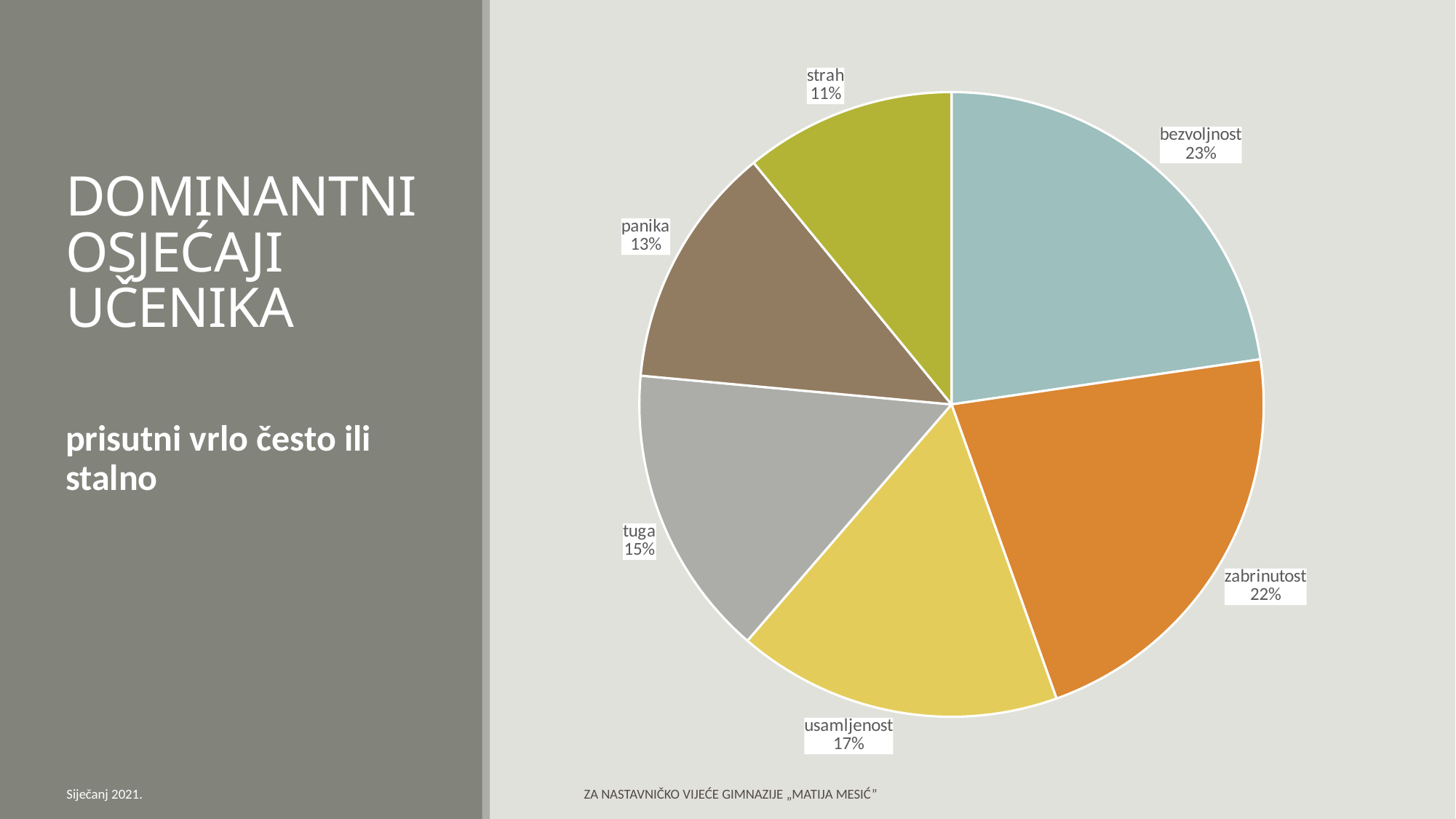
What is the difference in percentage points between usamljenost and panika? 4 How many slices does the pie chart have? 6 Which is larger, tuga or strah? tuga What share of the pie does strah have? 11% What share of the pie does bezvoljnost have? 23% What share of the pie does zabrinutost have? 22% Which slice of the pie is the smallest? strah What kind of chart is shown on the slide? pie chart Which slice of the pie is the largest? bezvoljnost